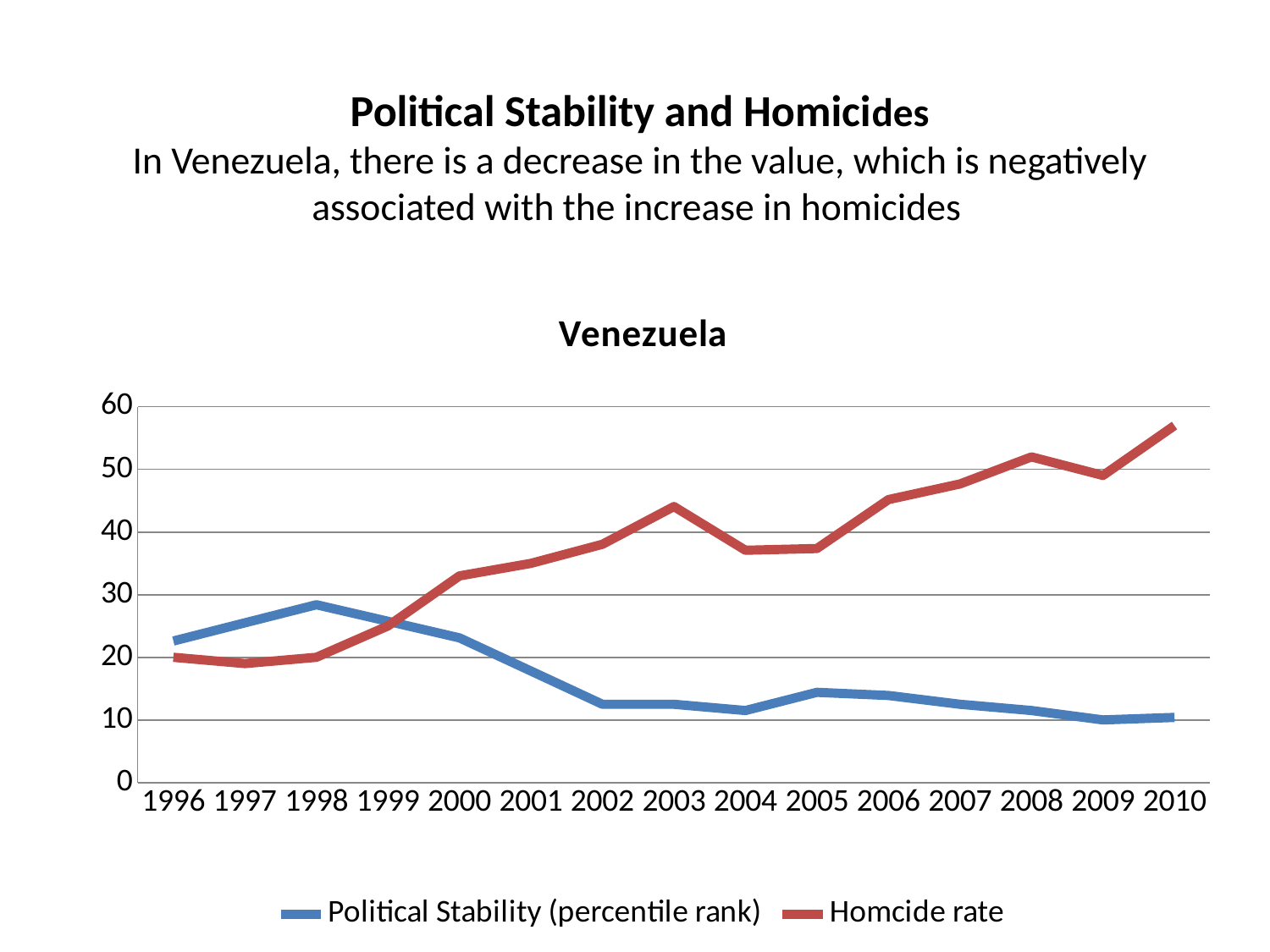
Is the Homcide rate in 2010 greater or less than 50? greater In which year is Political Stability (percentile rank) highest? 1998 How many years are plotted along the x axis? 15 Does Political Stability (percentile rank) generally rise or fall from 1998 to 2010? fall How many series does the legend list? 2 In which year is the Homcide rate highest? 2010 What is the title of the chart? Venezuela In 2010, which series has the larger value, Political Stability (percentile rank) or Homcide rate? Homcide rate Does the Homcide rate generally rise or fall from 1996 to 2010? rise Is the Political Stability (percentile rank) in 2004 greater or less than 20? less Is the Homcide rate in 1996 greater or less than 30? less What kind of chart is shown on the slide? line chart